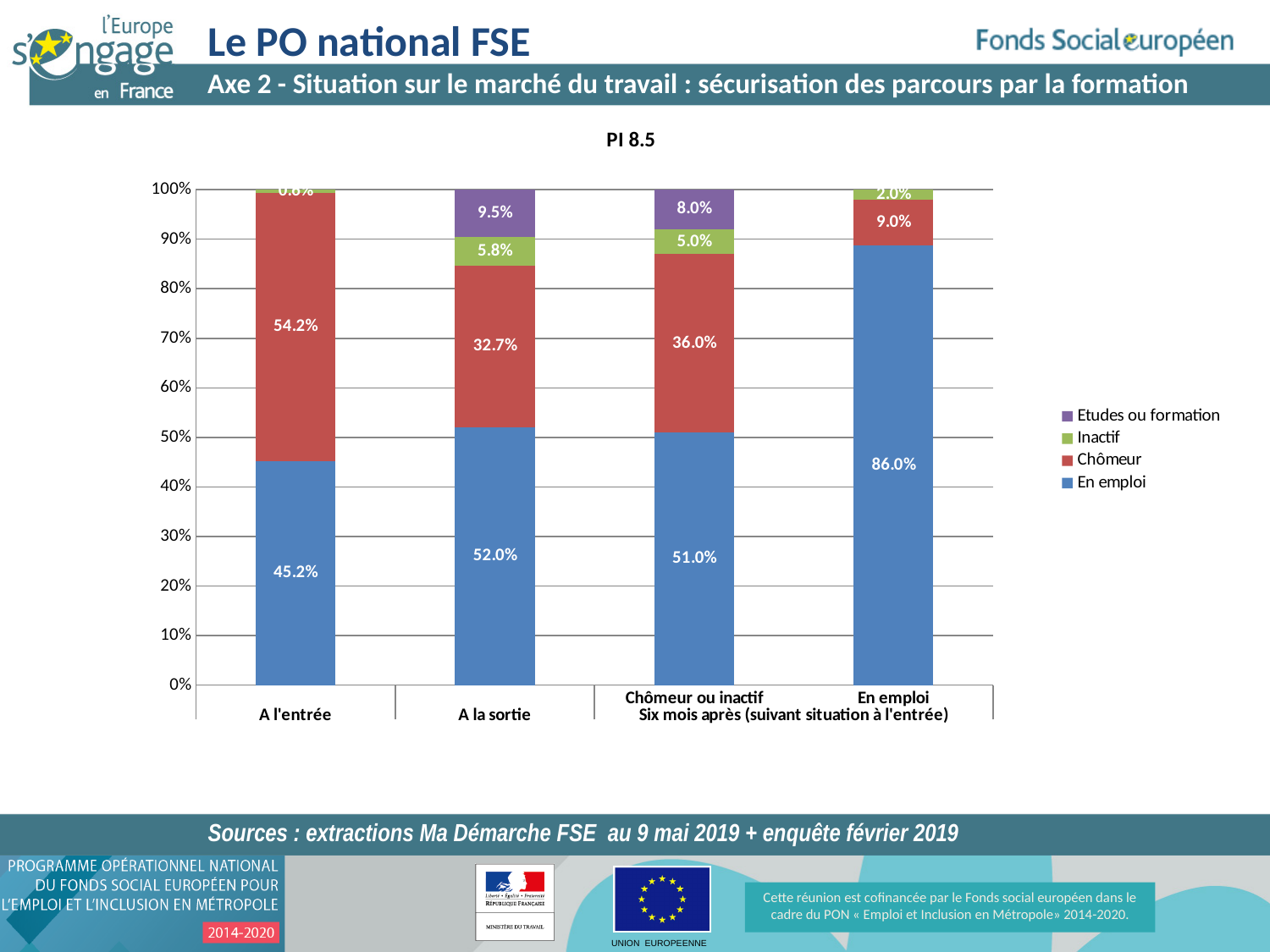
What is the difference between the 'Chômeur' share at 'A l'entrée' and at 'A la sortie'? 21.5% How many series does the legend list? 4 Which bar has the highest 'En emploi' share? En emploi (Six mois après) What is the 'Chômeur' share for the 'A la sortie' bar? 32.7% Which is larger: the 'Inactif' share for 'A la sortie' or for 'Chômeur ou inactif'? A la sortie What is the 'Etudes ou formation' share for the 'Chômeur ou inactif' bar (six mois après)? 8.0% What kind of chart is shown on the slide? Stacked bar chart How many bars (categories) are plotted on the x axis? 4 Which bar has the lowest 'Chômeur' share? En emploi (Six mois après) What is the 'En emploi' share for the 'A l'entrée' bar? 45.2% What is the 'En emploi' share for the 'En emploi' bar (six mois après)? 86.0% What is the chart title? PI 8.5